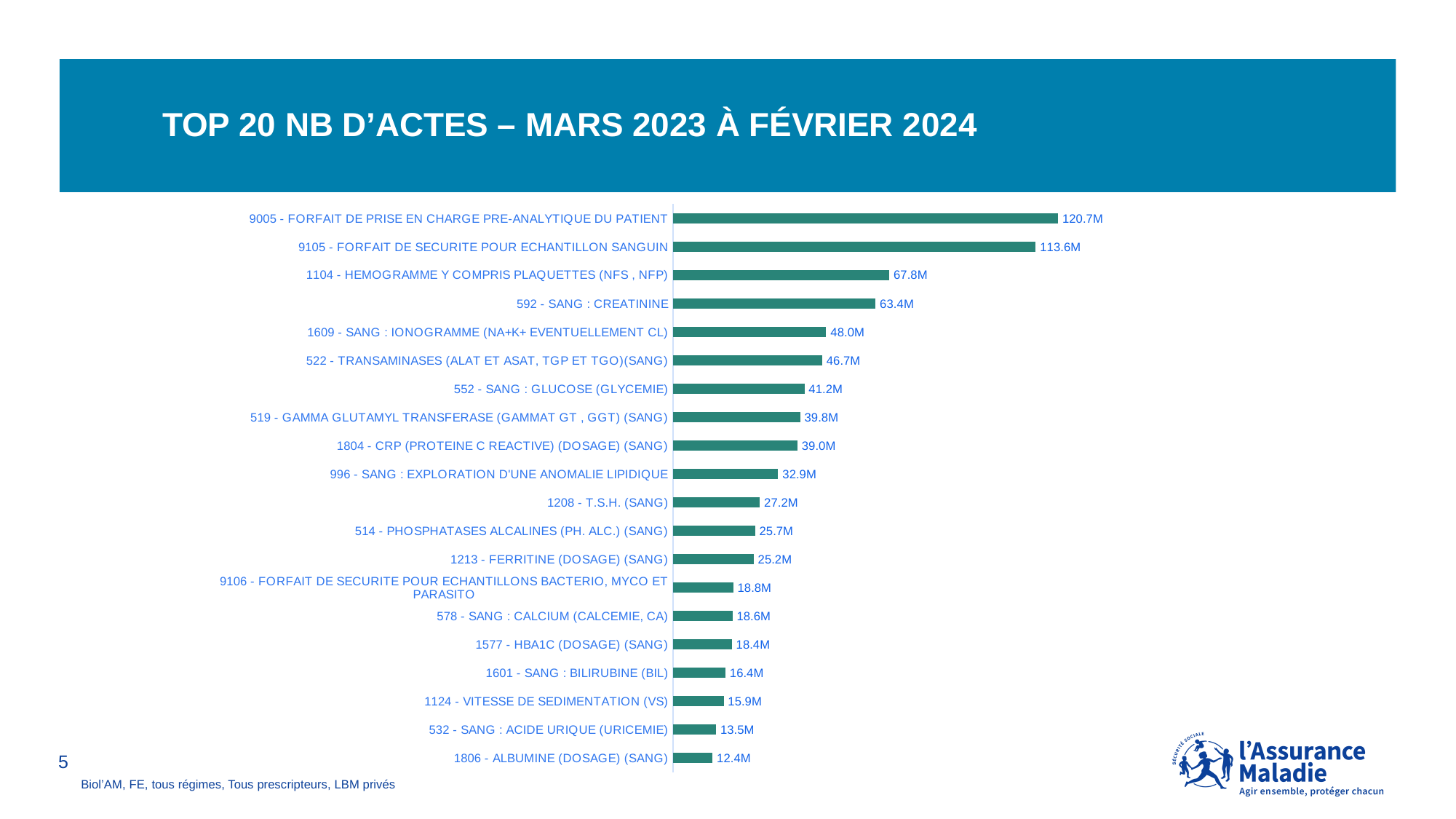
What is the difference between the values for 1104 - HEMOGRAMME Y COMPRIS PLAQUETTES (NFS , NFP) and 592 - SANG : CREATININE? 4.4M How many categories are shown in the chart? 20 Which is larger, the value for 552 - SANG : GLUCOSE (GLYCEMIE) or the value for 519 - GAMMA GLUTAMYL TRANSFERASE (GAMMAT GT , GGT) (SANG)? 552 - SANG : GLUCOSE (GLYCEMIE) What is the value for 592 - SANG : CREATININE? 63.4M Which category has the lowest value? 1806 - ALBUMINE (DOSAGE) (SANG) What is the difference between the values for 9005 - FORFAIT DE PRISE EN CHARGE PRE-ANALYTIQUE DU PATIENT and 9105 - FORFAIT DE SECURITE POUR ECHANTILLON SANGUIN? 7.1M Which category has the highest value? 9005 - FORFAIT DE PRISE EN CHARGE PRE-ANALYTIQUE DU PATIENT What kind of chart is shown on the slide? Bar chart Which is larger, the value for 1124 - VITESSE DE SEDIMENTATION (VS) or the value for 532 - SANG : ACIDE URIQUE (URICEMIE)? 1124 - VITESSE DE SEDIMENTATION (VS) What is the title of the slide? TOP 20 NB D’ACTES – MARS 2023 À FÉVRIER 2024 What is the value for 1577 - HBA1C (DOSAGE) (SANG)? 18.4M What is the value for 1208 - T.S.H. (SANG)? 27.2M